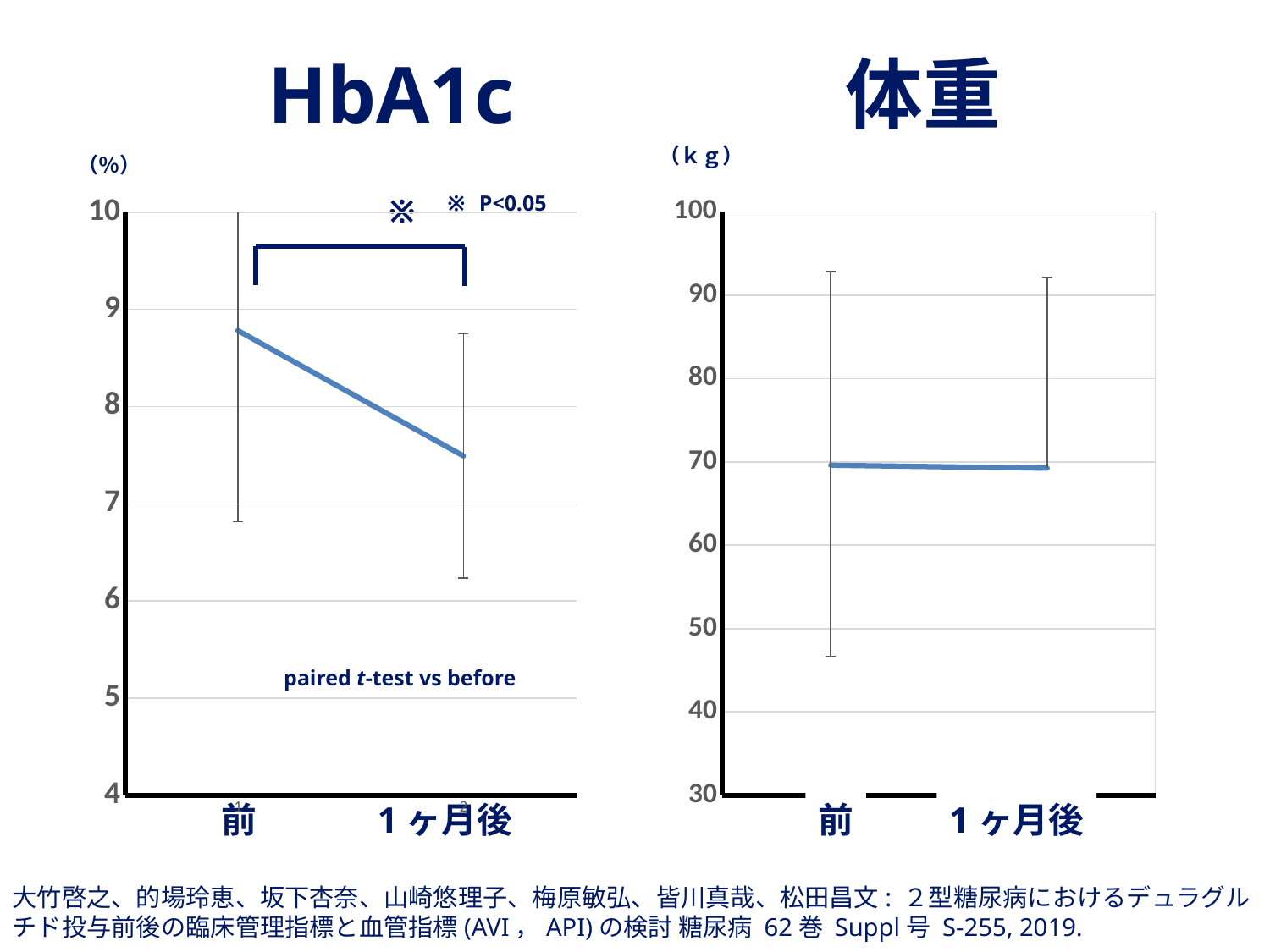
On the 体重 chart, is the value for 前 greater or less than 80? less On the 体重 chart, is the value for 1ヶ月後 greater or less than 60? greater How many time points are plotted on the HbA1c chart? 2 On the HbA1c chart, which time point has the larger value, 前 or 1ヶ月後? 前 What kind of chart is the HbA1c chart on the left? line chart On the HbA1c chart, is the value for 1ヶ月後 greater or less than 8? less How many time points are plotted on the 体重 chart? 2 What unit is shown on the y axis of the 体重 chart? kg What significance level is indicated by the ※ annotation on the HbA1c chart? P<0.05 On the HbA1c chart, does the line rise or fall from 前 to 1ヶ月後? fall What kind of chart is the 体重 chart on the right? line chart